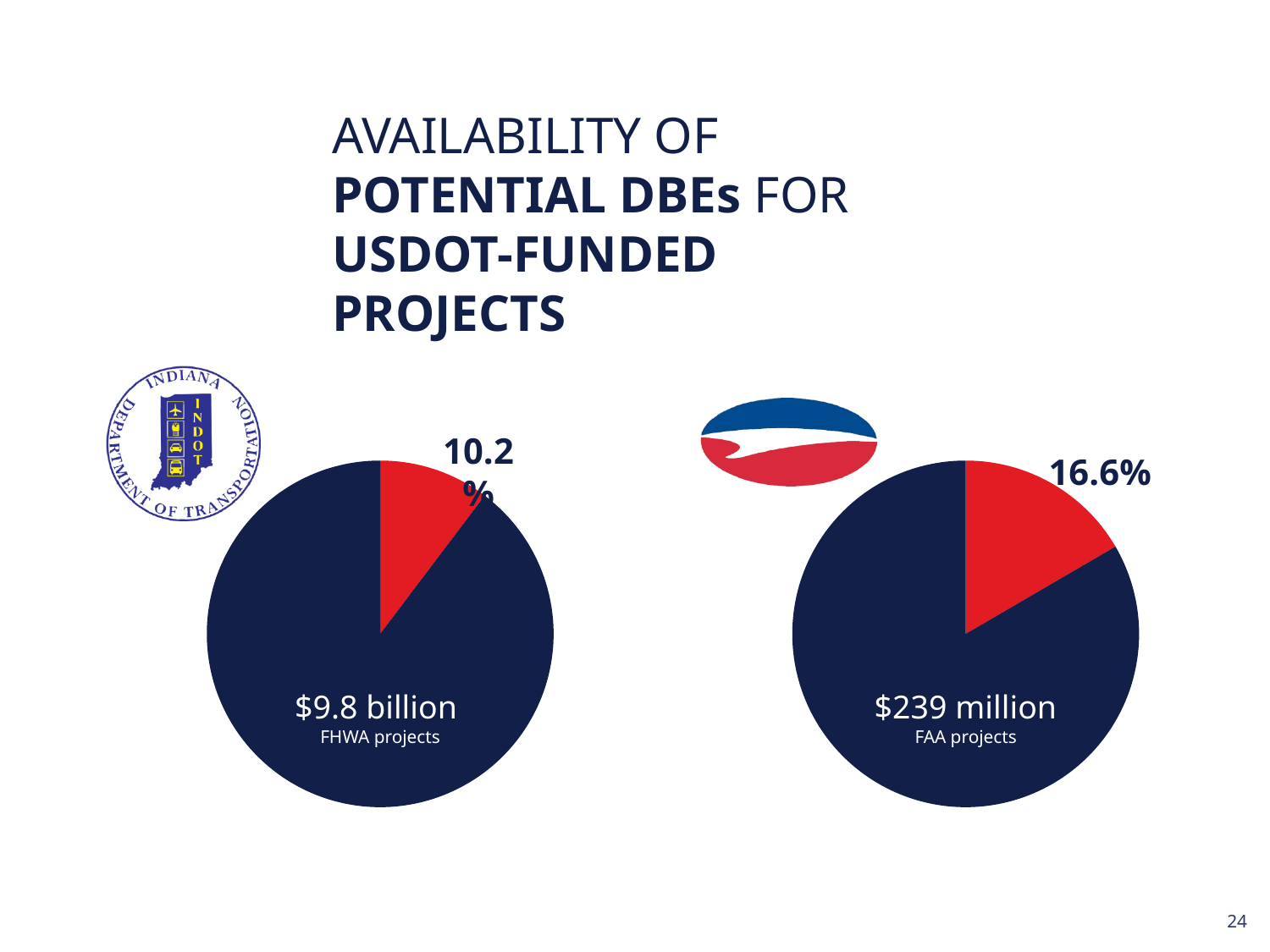
On the left pie chart, is the red slice greater or less than 50% of the pie? less Which projects does the left pie chart refer to? FHWA projects What dollar amount is printed in the centre of the right pie chart? $239 million On the left pie chart (FHWA projects), what percentage is shown for the red slice? 10.2% Which pie chart has the larger red slice, the FHWA projects chart or the FAA projects chart? FAA projects What type of chart is used on this slide? Pie chart What is the difference between the percentage shown on the FAA projects pie and the percentage shown on the FHWA projects pie? 6.4% How many pie charts are on the slide? 2 On the right pie chart (FAA projects), what percentage is shown for the red slice? 16.6% What dollar amount is printed in the centre of the left pie chart? $9.8 billion What colour is the slice labelled 16.6% on the right pie chart? Red On the right pie chart, is the dark blue portion greater or less than 50% of the pie? greater